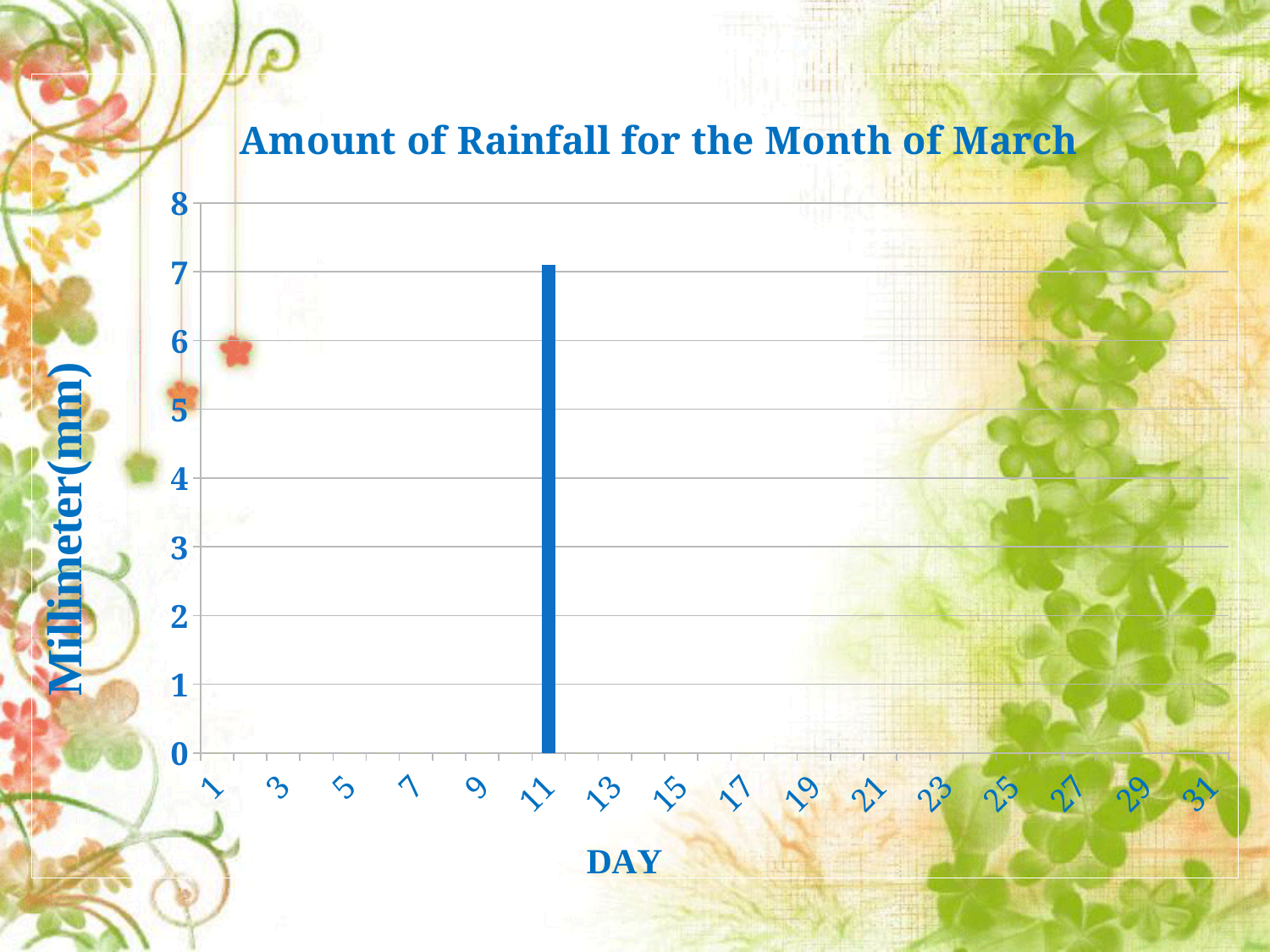
What is the label on the vertical axis of the chart? Millimeter(mm) Is the rainfall value for day 11 greater or less than 6? greater What is the title of the chart? Amount of Rainfall for the Month of March Is the rainfall value for day 11 greater or less than 8? less Is the rainfall value for day 11 greater or less than 4? greater On which day does the chart show the highest rainfall? 11 What is the last day label shown on the horizontal axis? 31 What is the highest value shown on the vertical axis? 8 How many day labels are printed along the horizontal axis? 16 What kind of chart is shown on the slide? bar chart How many bars are visible in the chart? 1